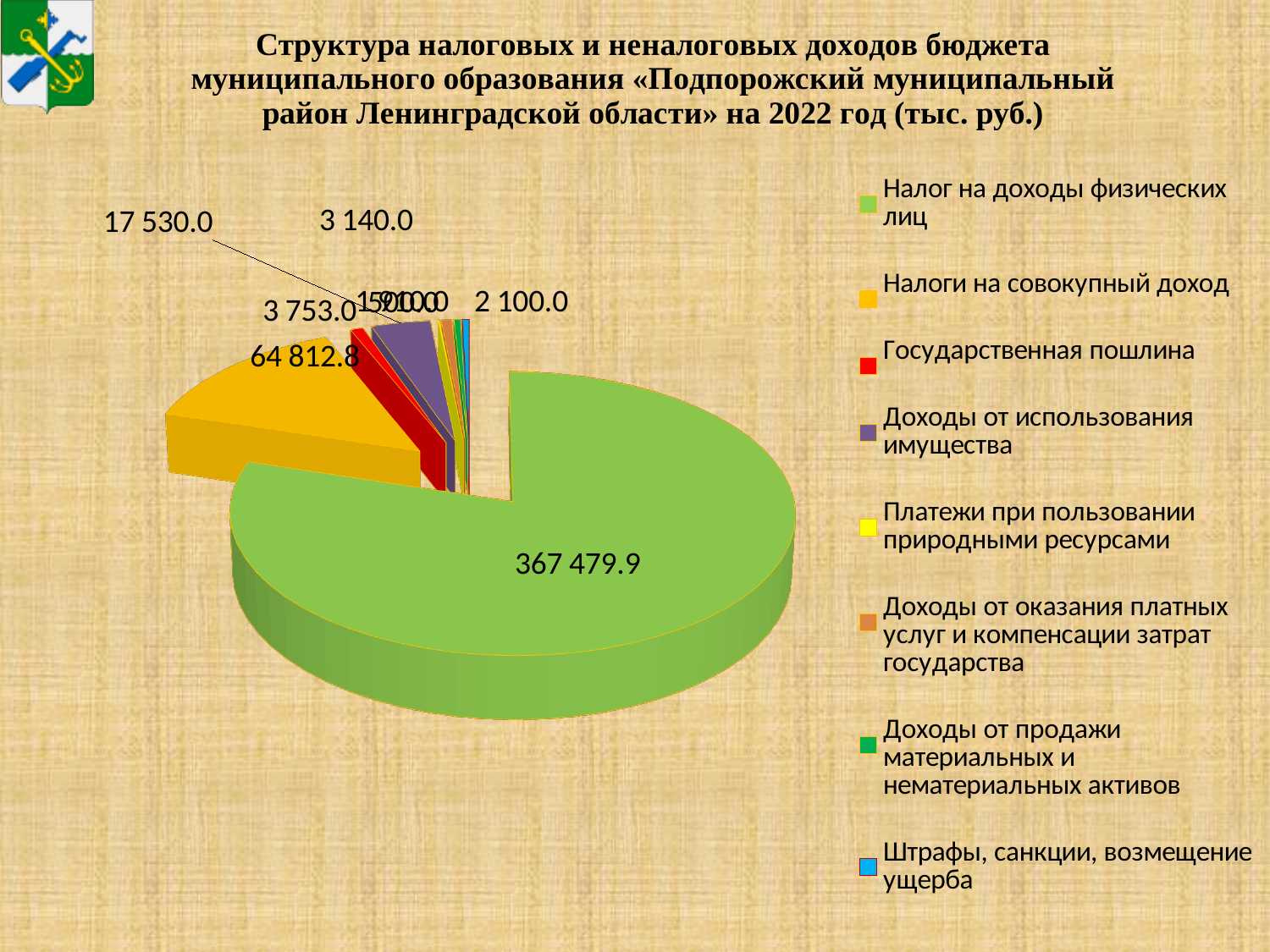
What colour is the slice for «Налог на доходы физических лиц»? green What is the difference between «Налог на доходы физических лиц» and «Налоги на совокупный доход»? 302 667.1 What is the value for «Штрафы, санкции, возмещение ущерба»? 2 100.0 What is the value for «Доходы от использования имущества»? 17 530.0 What kind of chart is shown on the slide? pie chart What is the difference between «Доходы от использования имущества» and «Государственная пошлина»? 13 777.0 What is the value for «Налоги на совокупный доход»? 64 812.8 How many categories does the legend of the pie chart list? 8 Which is larger: «Налоги на совокупный доход» or «Государственная пошлина»? Налоги на совокупный доход Which category has the largest slice of the pie? Налог на доходы физических лиц What is the value for «Государственная пошлина»? 3 753.0 What is the value for «Налог на доходы физических лиц»? 367 479.9